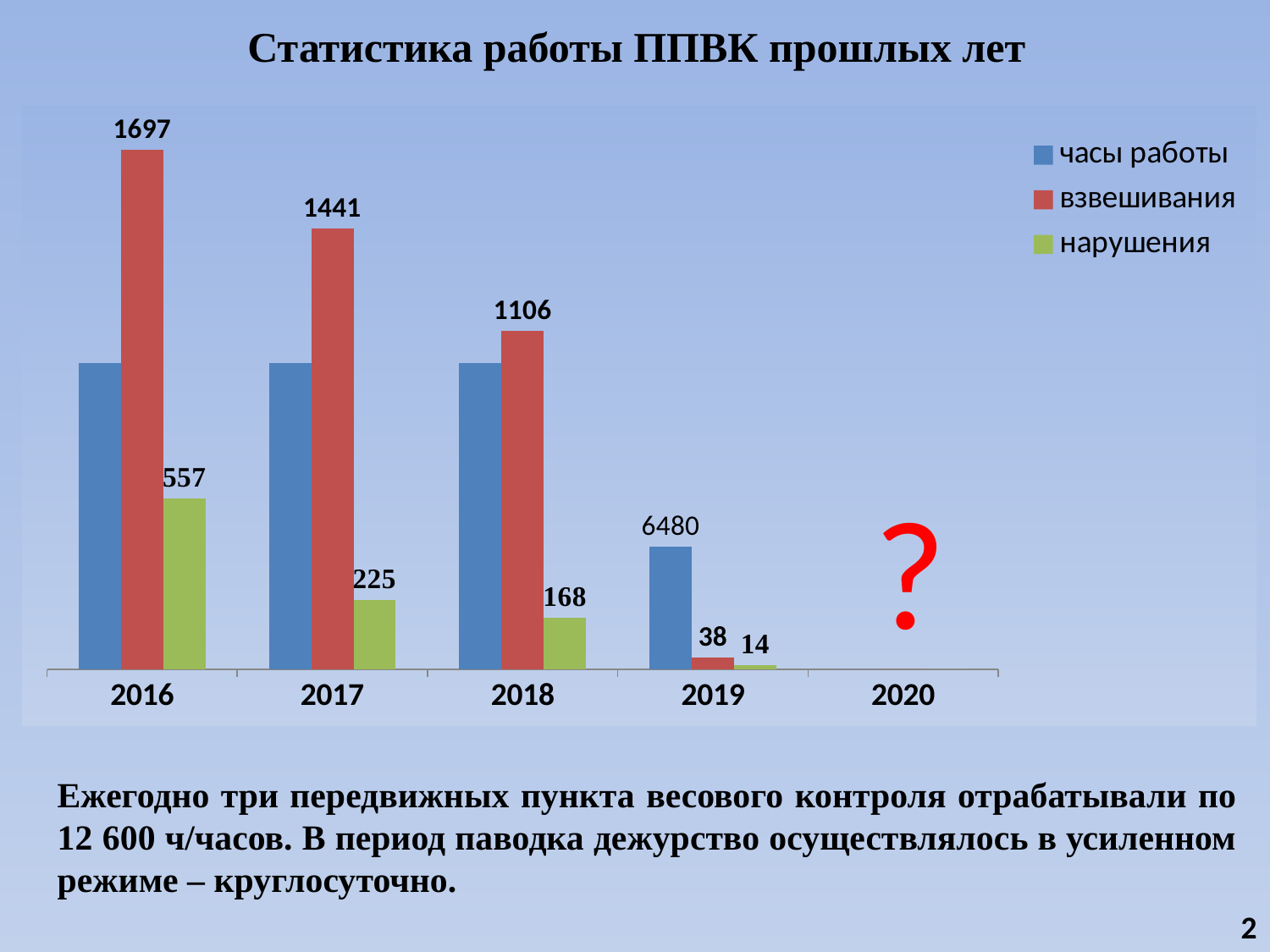
How many series does the legend list? 3 In 2018, which is larger: взвешивания or нарушения? взвешивания How many years are shown on the x axis? 5 What is the difference between the нарушения values for 2016 and 2018? 389 What is the value of взвешивания for 2016? 1697 What kind of chart is shown on the slide? bar chart Which year has the highest value for взвешивания? 2016 Do the взвешивания values rise or fall from 2016 to 2019? fall What is the value of часы работы for 2019? 6480 What is the difference between the взвешивания values for 2016 and 2017? 256 What is the value of нарушения for 2017? 225 Among the years with a labelled value, which year has the lowest value for нарушения? 2019